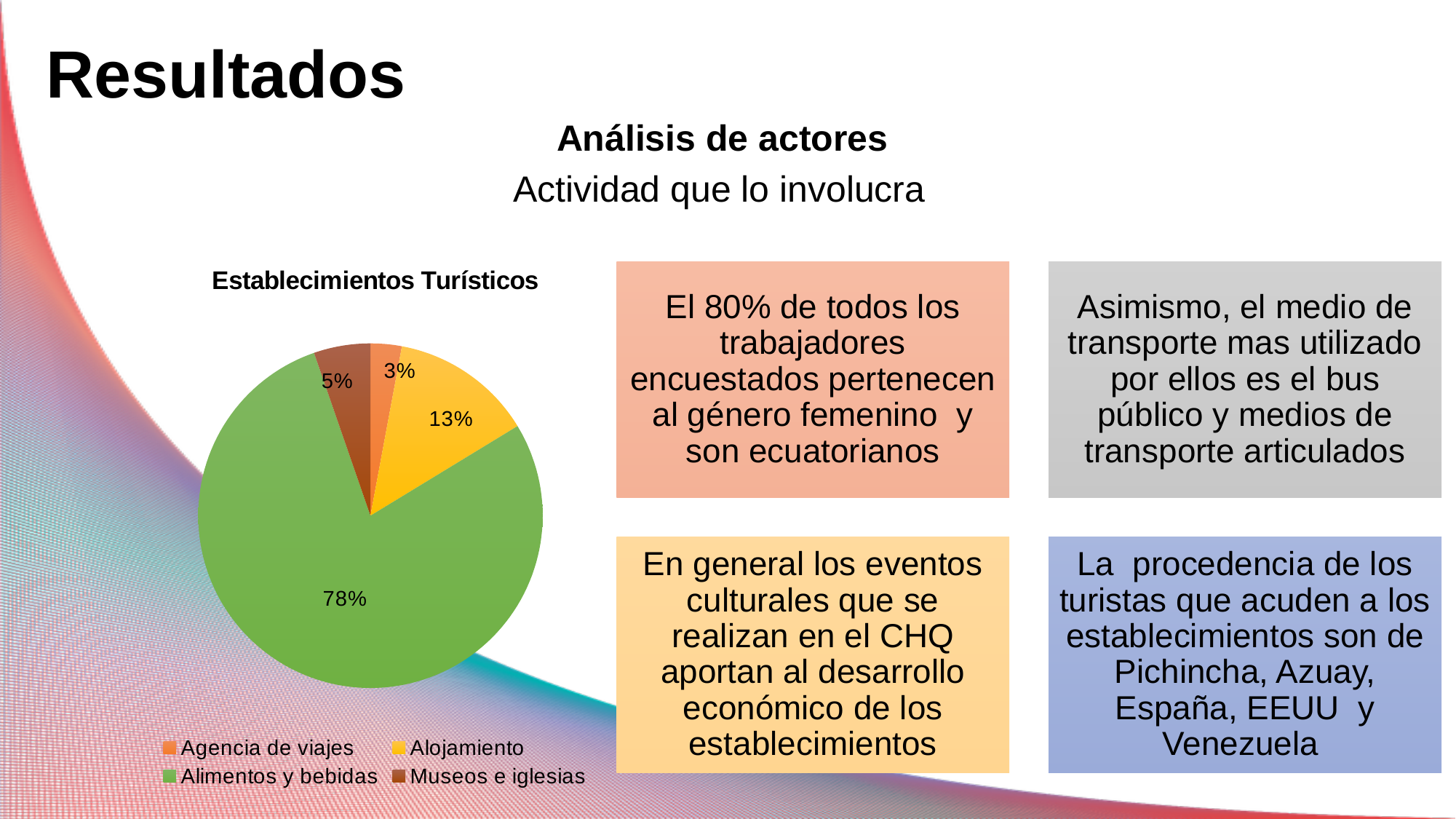
Which category has the largest slice of the pie? Alimentos y bebidas Which is larger, the share for Museos e iglesias or the share for Agencia de viajes? Museos e iglesias What is the difference in percentage points between Alimentos y bebidas and Alojamiento? 65 How many categories does the pie chart show? 4 What share of the pie does Museos e iglesias have? 5% What share of the pie does Agencia de viajes have? 3% What kind of chart is shown on the slide? Pie chart What share of the pie does Alimentos y bebidas have? 78% What is the title of the chart? Establecimientos Turísticos What colour is the slice for Alimentos y bebidas? Green Which category has the smallest slice of the pie? Agencia de viajes